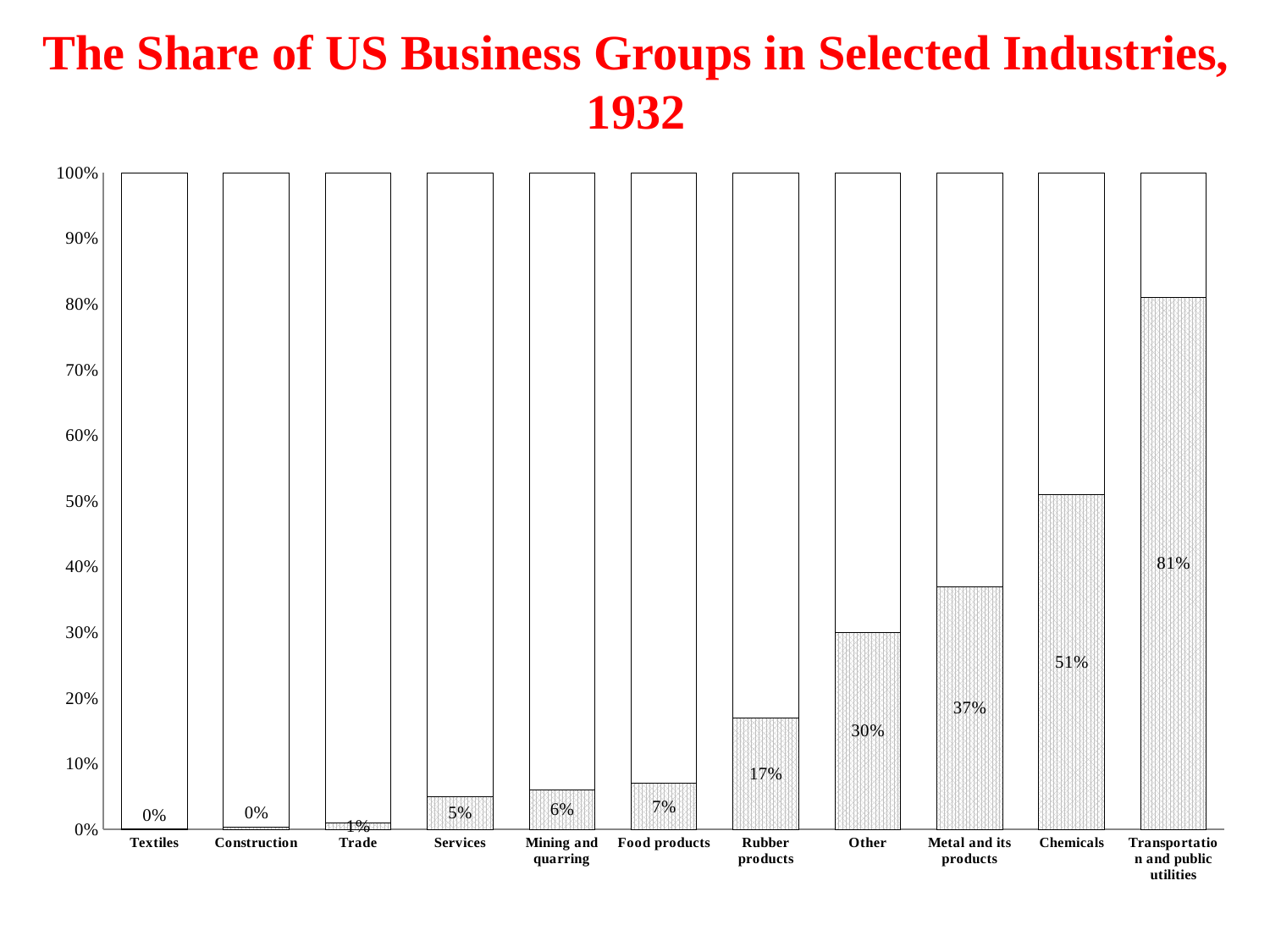
Do the shaded shares rise or fall moving from left to right along the x axis? Rise What is the share of US business groups in Metal and its products? 37% What is the difference between the shares for Other and Rubber products? 13% What is the share of US business groups in Rubber products? 17% What kind of chart is shown on the slide? Stacked bar chart What is the difference between the shares for Transportation and public utilities and Chemicals? 30% Is the share for Transportation and public utilities greater or less than 80%? greater Which has a larger share of US business groups, Food products or Mining and quarring? Food products What is the share of US business groups in Chemicals? 51% How many industries are shown on the x axis? 11 What is the share of US business groups in Services? 5% Which industry has the highest share of US business groups? Transportation and public utilities